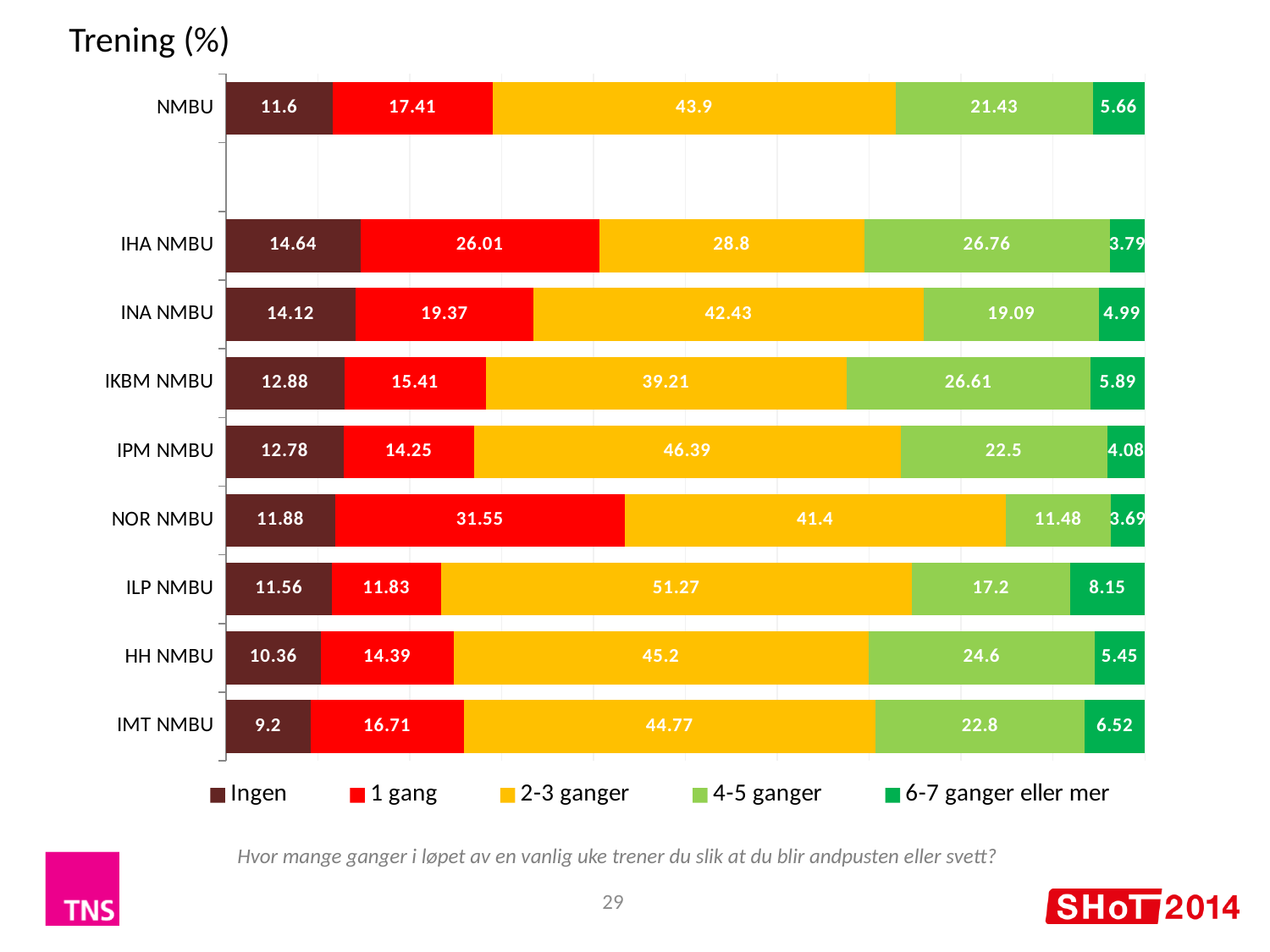
What is the value for '1 gang' for NOR NMBU? 31.55 How many series does the legend list? 5 What is the difference between the '4-5 ganger' and '6-7 ganger eller mer' values for NMBU? 15.77 What is the value for '6-7 ganger eller mer' for ILP NMBU? 8.15 What is the total of the stacked bar for NMBU? 100 What is the value for '2-3 ganger' for NMBU? 43.9 How many categories are shown on the y axis? 9 Which category has the lowest value for 'Ingen'? IMT NMBU Which category has the highest value for 'Ingen'? IHA NMBU Which category has the highest value for '2-3 ganger'? ILP NMBU What kind of chart is shown? Stacked bar chart Which has the larger '4-5 ganger' value, IKBM NMBU or IPM NMBU? IKBM NMBU